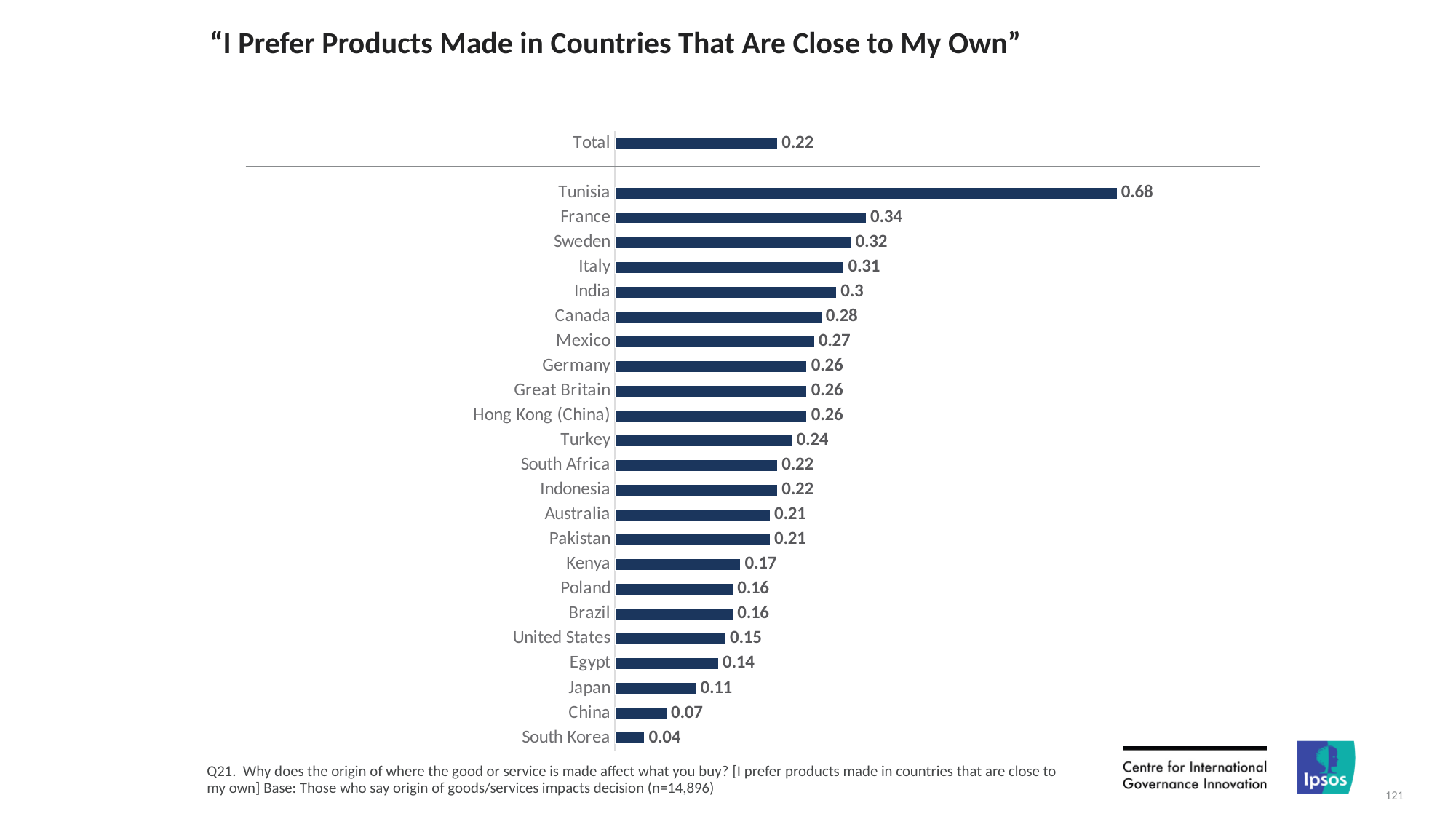
What is the value for Canada? 0.28 How many countries are listed below the Total bar? 23 Which country has the highest value? Tunisia What is the value for Japan? 0.11 What is the difference between the values for Tunisia and France? 0.34 What kind of chart is shown on the slide? Bar chart What is the value for Tunisia? 0.68 What is the value shown for Total? 0.22 What is the difference between the values for China and South Korea? 0.03 What is the title of the chart? "I Prefer Products Made in Countries That Are Close to My Own" Which has a larger value, Sweden or Mexico? Sweden Which country has the lowest value? South Korea